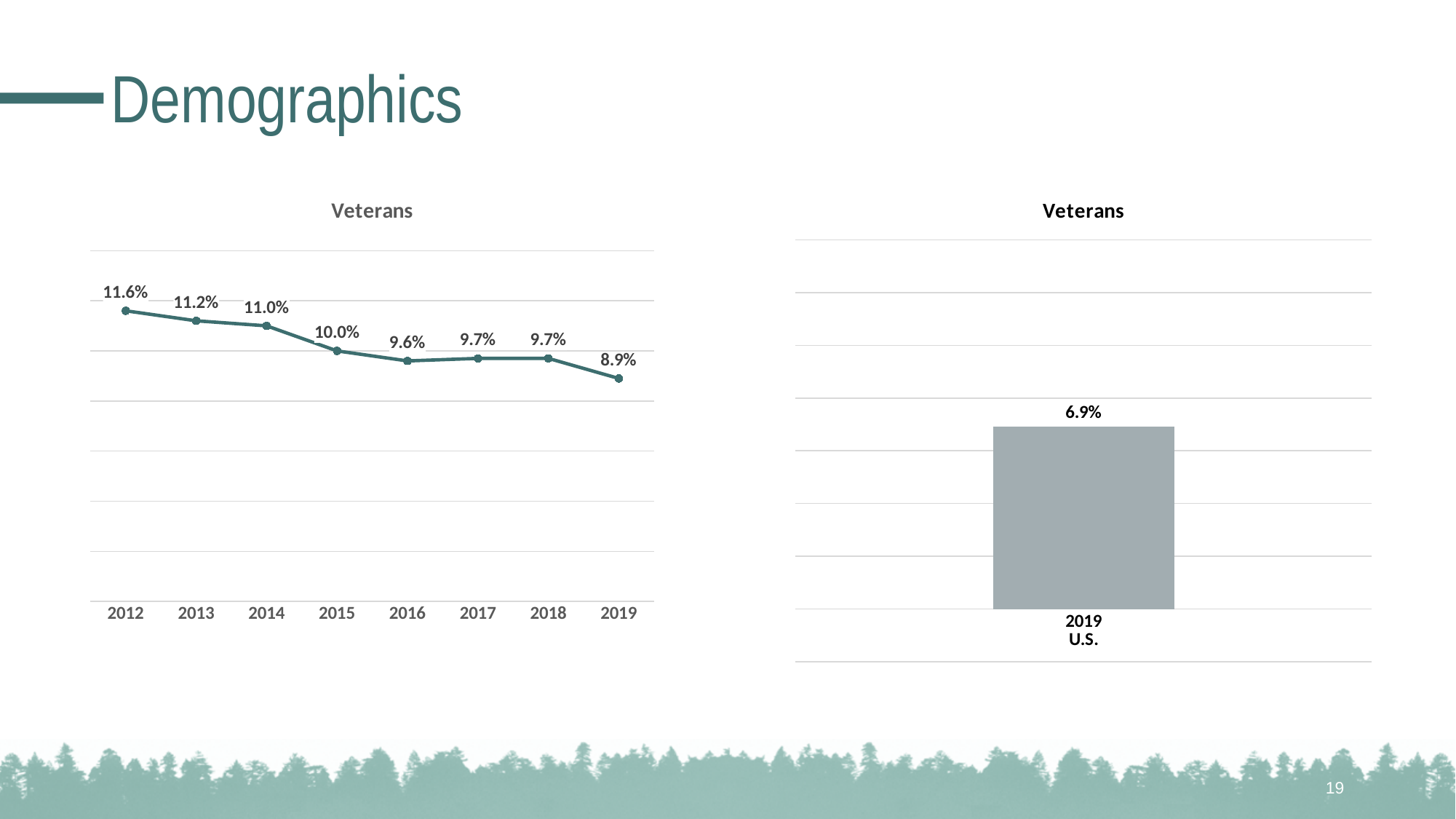
In the left-hand Veterans line chart, which is larger, the value for 2014 or the value for 2015? 2014 In the right-hand Veterans bar chart, what is the value for 2019 U.S.? 6.9% In the left-hand Veterans line chart, what is the value for 2019? 8.9% What kind of chart is the left-hand Veterans chart? line chart In the left-hand Veterans line chart, which year has the lowest value? 2019 In the left-hand Veterans line chart, what is the value for 2012? 11.6% In the left-hand Veterans line chart, what is the difference between the 2012 value and the 2019 value? 2.7% In the left-hand Veterans line chart, do the values generally rise or fall from 2012 to 2019? fall In the left-hand Veterans line chart, how many years are plotted on the x axis? 8 In the left-hand Veterans line chart, what is the value for 2016? 9.6% In the left-hand Veterans line chart, which year has the highest value? 2012 What kind of chart is the right-hand Veterans chart? bar chart